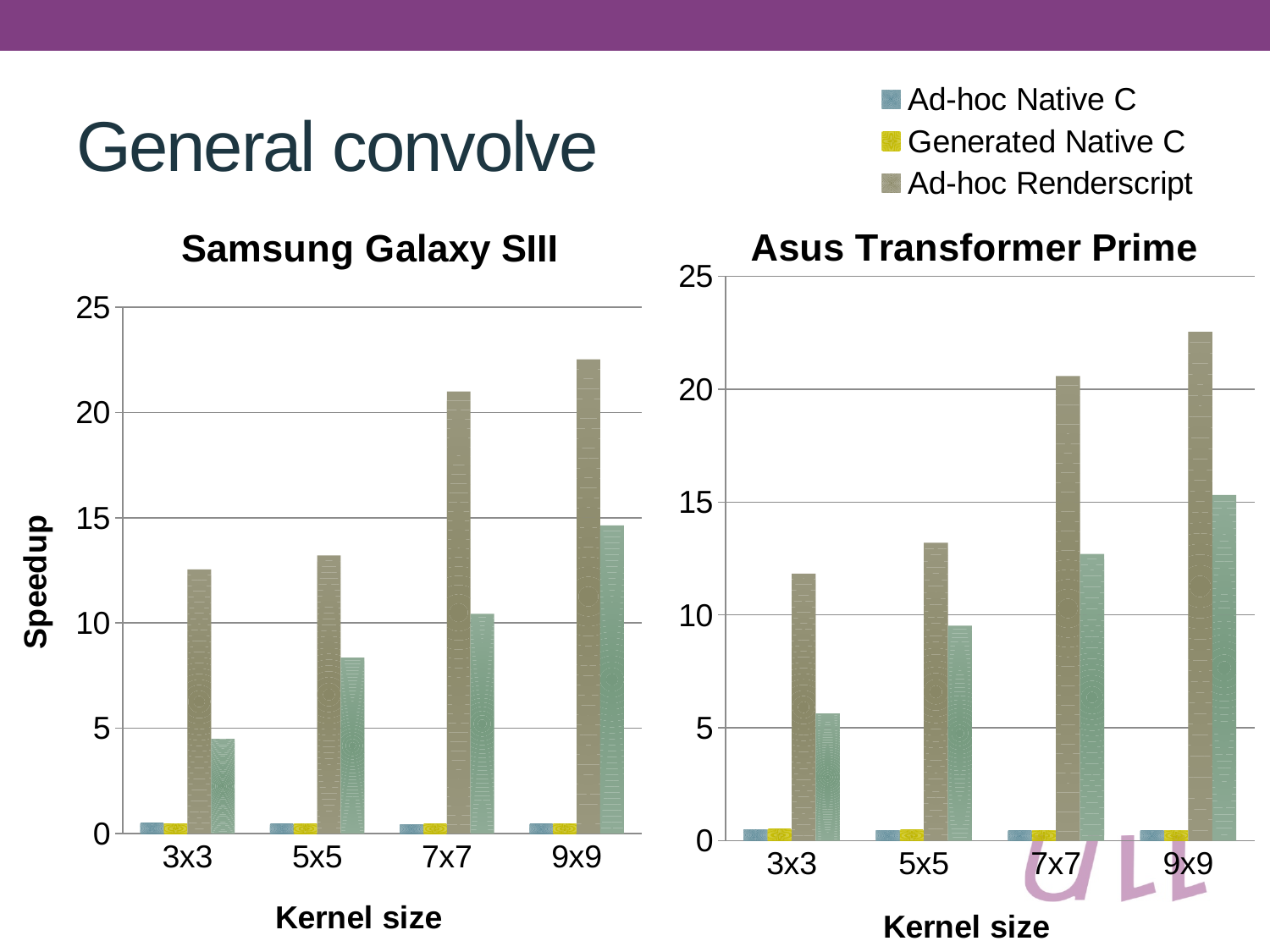
In the Asus Transformer Prime chart, is the Ad-hoc Native C value for 3x3 greater or less than 5? less In the Asus Transformer Prime chart, which kernel size has the lowest Ad-hoc Renderscript speedup? 3x3 What is the y-axis title of the Samsung Galaxy SIII chart? Speedup How many series does the legend on the slide list? 3 In the Samsung Galaxy SIII chart, is the Ad-hoc Renderscript value for 9x9 greater or less than 20? greater In the Asus Transformer Prime chart, is the Ad-hoc Renderscript value for 5x5 greater or less than 15? less What kind of chart is the Samsung Galaxy SIII chart? bar chart In the Asus Transformer Prime chart, which is larger, the Ad-hoc Renderscript value for 3x3 or for 9x9? 9x9 In the Samsung Galaxy SIII chart, which kernel size has the highest Ad-hoc Renderscript speedup? 9x9 In the Samsung Galaxy SIII chart, does the Ad-hoc Renderscript speedup rise or fall as the kernel size increases from 3x3 to 9x9? rise How many kernel size categories are shown on the x axis of the Samsung Galaxy SIII chart? 4